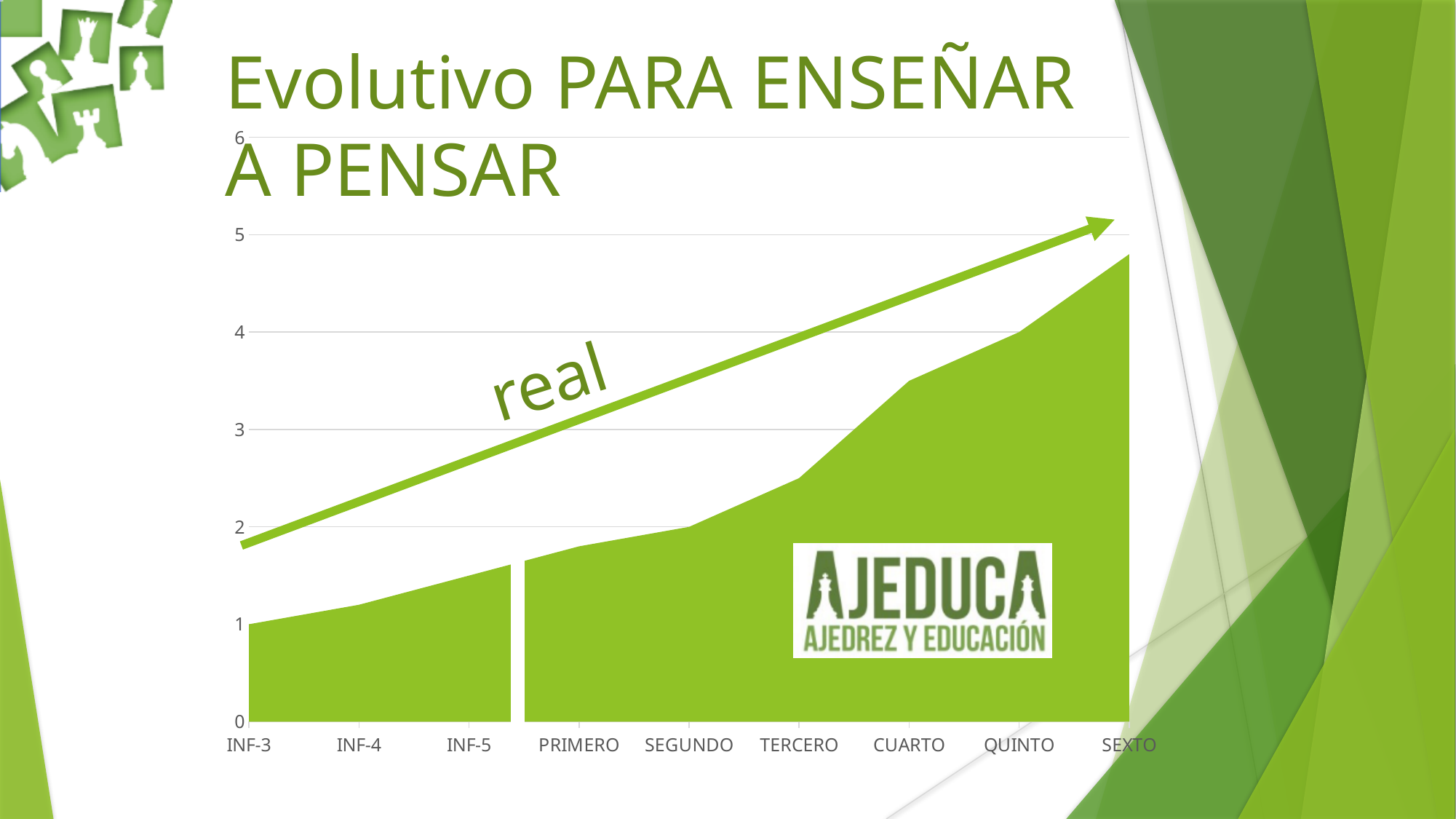
What is the value for INF-3? 1 Which category has the highest value in the chart? SEXTO What kind of chart is shown on the slide? area chart Is the value for INF-5 greater or less than 2? less Which category has the lowest value in the chart? INF-3 Is the value for CUARTO greater or less than 3? greater How many categories are shown on the x axis of the chart? 9 Is the value for SEXTO greater or less than 4? greater What word is written along the arrow drawn above the area in the chart? real Which is larger, the value for CUARTO or the value for TERCERO? CUARTO Do the values rise or fall from INF-3 to SEXTO? rise